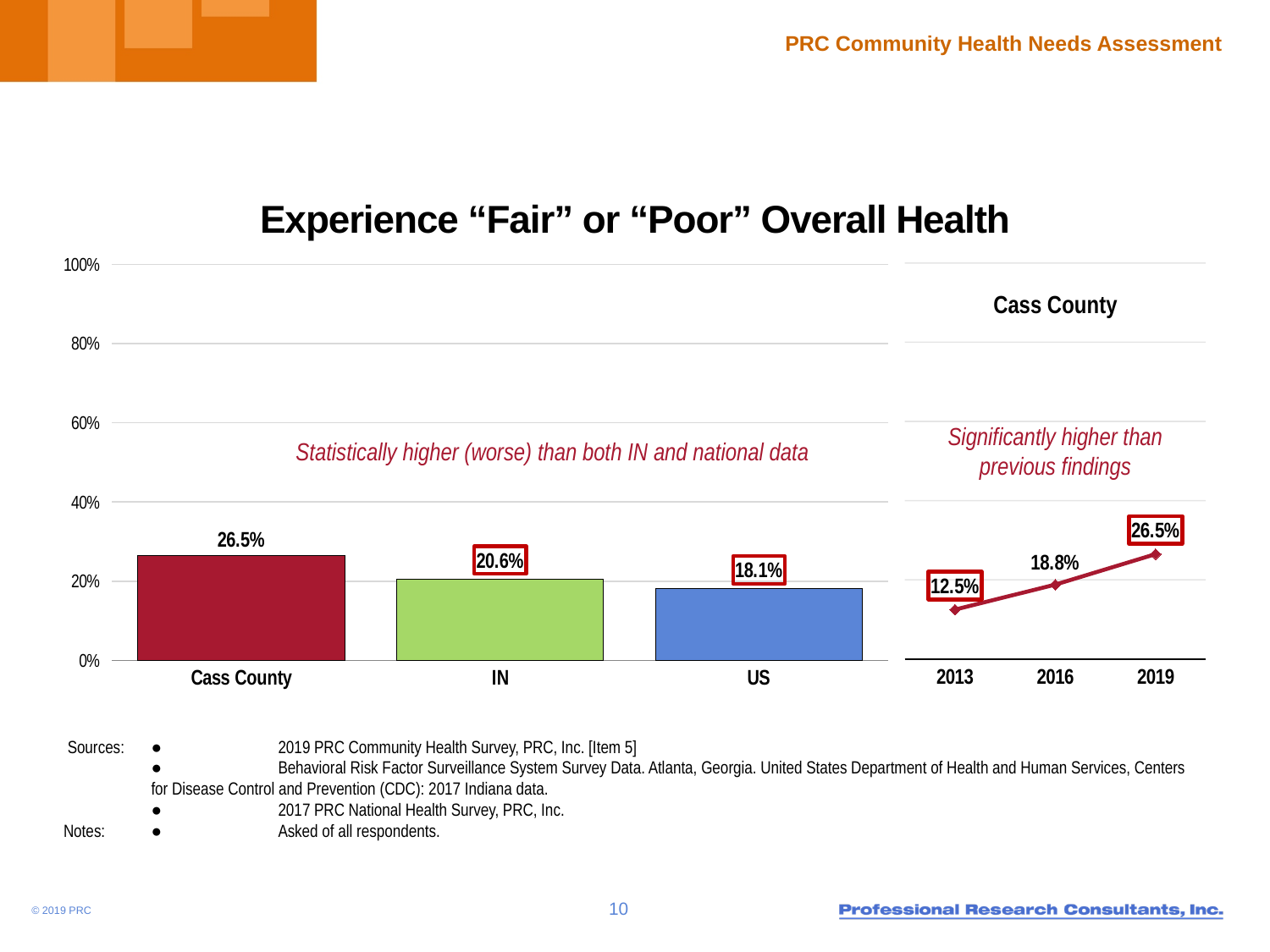
In the bar chart on the left, which category has the lowest value? US In the line chart on the right (Cass County), what is the value for 2013? 12.5% In the line chart on the right (Cass County), do the values rise or fall from 2013 to 2019? rise In the bar chart on the left, which category has the highest value? Cass County In the bar chart on the left, what is the value for IN? 20.6% In the bar chart on the left, what is the value for Cass County? 26.5% In the line chart on the right (Cass County), what is the value for 2016? 18.8% In the bar chart on the left, what is the difference between the Cass County value and the US value? 8.4% In the bar chart on the left, what is the value for US? 18.1% In the bar chart on the left, how many categories are shown? 3 In the line chart on the right (Cass County), what is the difference between the 2019 value and the 2013 value? 14.0% What is the title of the chart on the slide? Experience "Fair" or "Poor" Overall Health